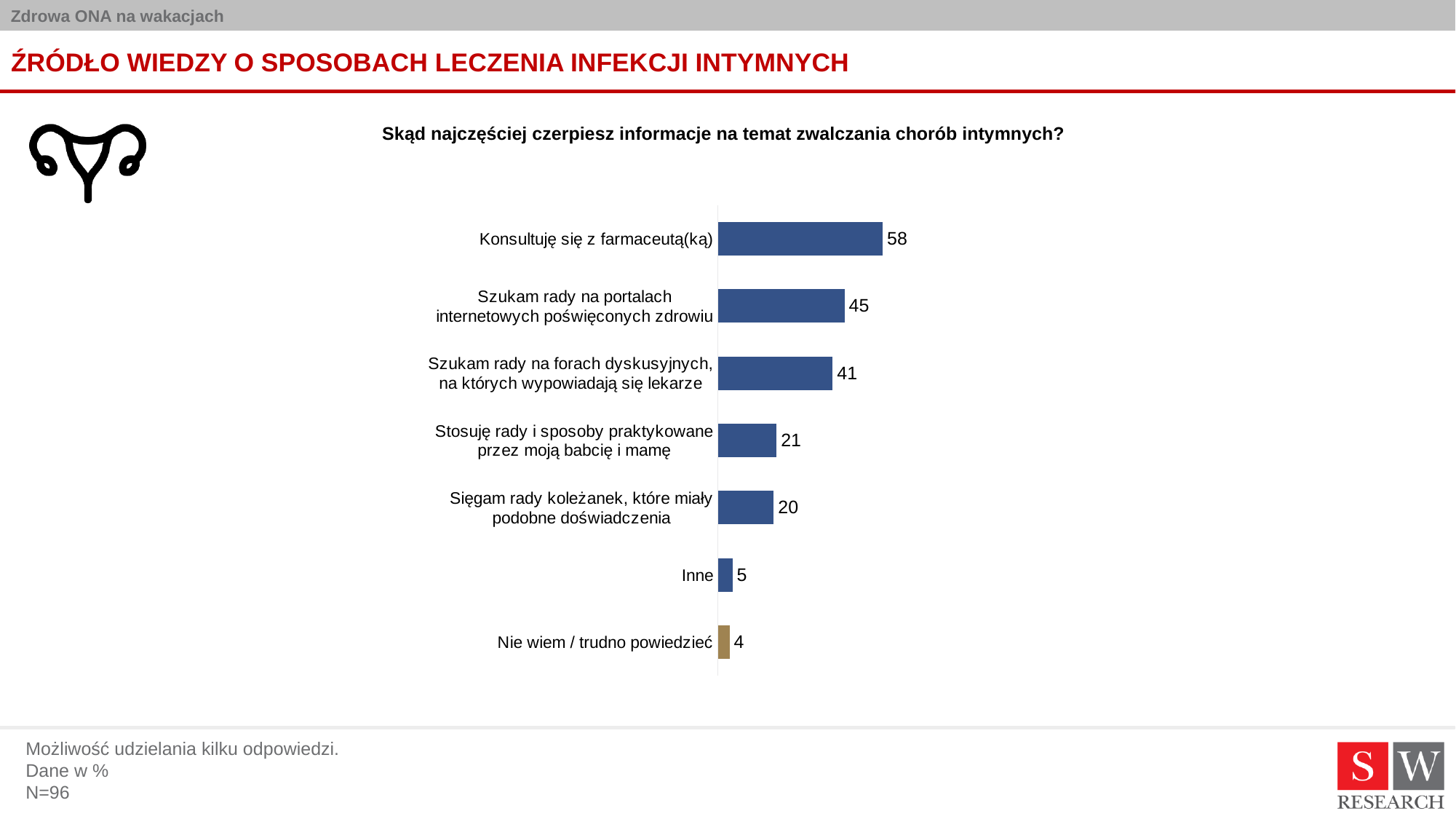
How many categories are shown in the chart? 7 What kind of chart is shown on the slide? Bar chart Which is larger: the value for "Szukam rady na portalach internetowych poświęconych zdrowiu" or for "Szukam rady na forach dyskusyjnych, na których wypowiadają się lekarze"? Szukam rady na portalach internetowych poświęconych zdrowiu What is the value for "Szukam rady na portalach internetowych poświęconych zdrowiu"? 45 What is the value for "Stosuję rady i sposoby praktykowane przez moją babcię i mamę"? 21 Which category has the lowest value? Nie wiem / trudno powiedzieć Which category has the highest value? Konsultuję się z farmaceutą(ką) What is the value for "Inne"? 5 What is the difference between the values for "Konsultuję się z farmaceutą(ką)" and "Szukam rady na portalach internetowych poświęconych zdrowiu"? 13 What is the difference between the values for "Szukam rady na forach dyskusyjnych, na których wypowiadają się lekarze" and "Sięgam rady koleżanek, które miały podobne doświadczenia"? 21 What question is shown as the chart's title? Skąd najczęściej czerpiesz informacje na temat zwalczania chorób intymnych? What is the value for "Konsultuję się z farmaceutą(ką)"? 58